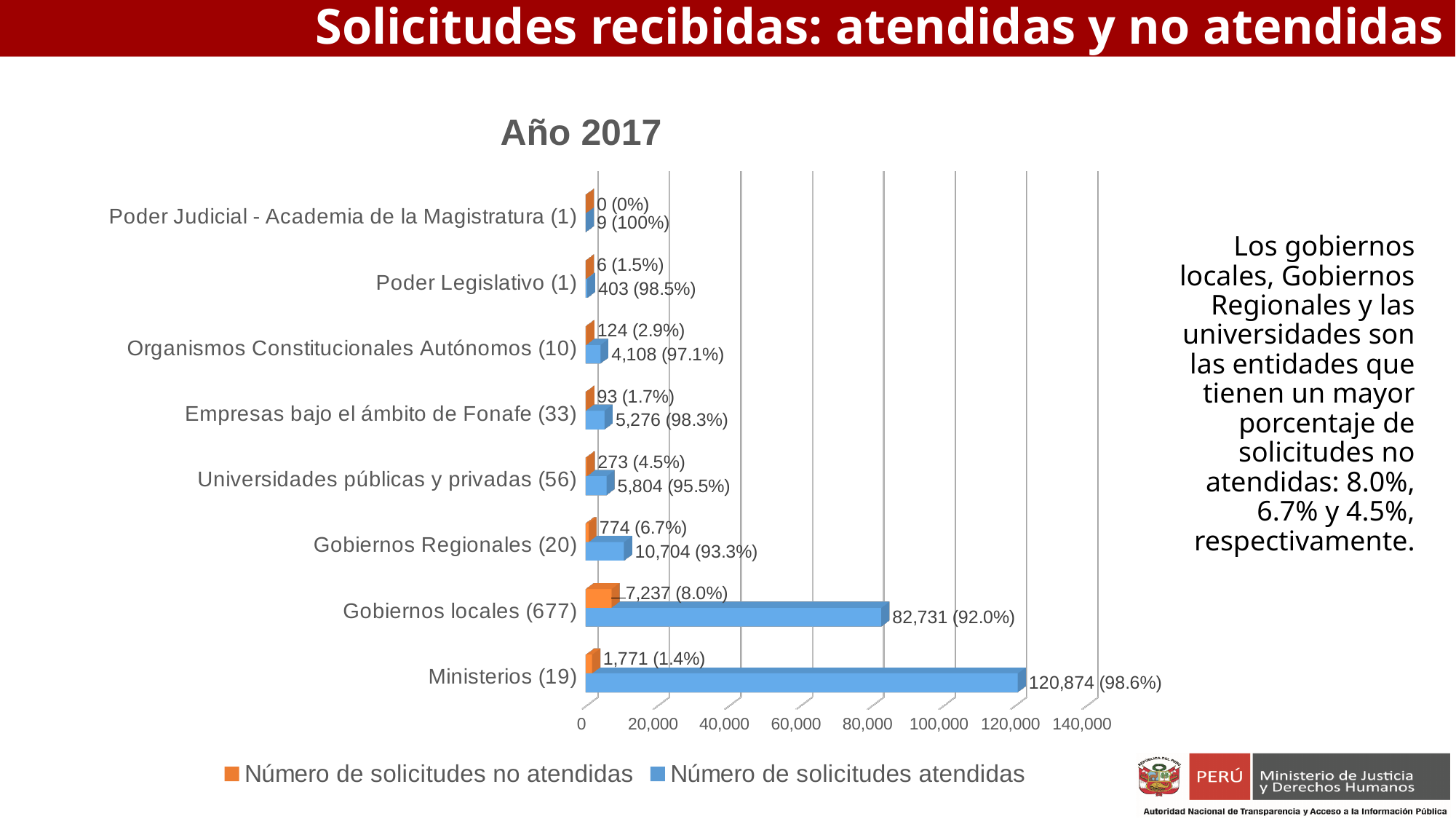
How many series does the legend list? 2 How many categories (entity types) are shown on the chart? 8 What type of chart is shown on the slide? bar chart What is the number of solicitudes atendidas for Ministerios (19)? 120,874 (98.6%) What is the difference between the solicitudes atendidas for Ministerios (19) and for Gobiernos locales (677)? 38,143 Which is larger: the solicitudes no atendidas for Gobiernos Regionales (20) or for Organismos Constitucionales Autónomos (10)? Gobiernos Regionales (20) What is the title of the chart? Año 2017 What is the number of solicitudes atendidas for Gobiernos Regionales (20)? 10,704 (93.3%) What is the number of solicitudes no atendidas for Universidades públicas y privadas (56)? 273 (4.5%) Which category has the lowest number of solicitudes no atendidas? Poder Judicial - Academia de la Magistratura (1) Which category has the highest number of solicitudes atendidas? Ministerios (19) What is the number of solicitudes no atendidas for Gobiernos locales (677)? 7,237 (8.0%)